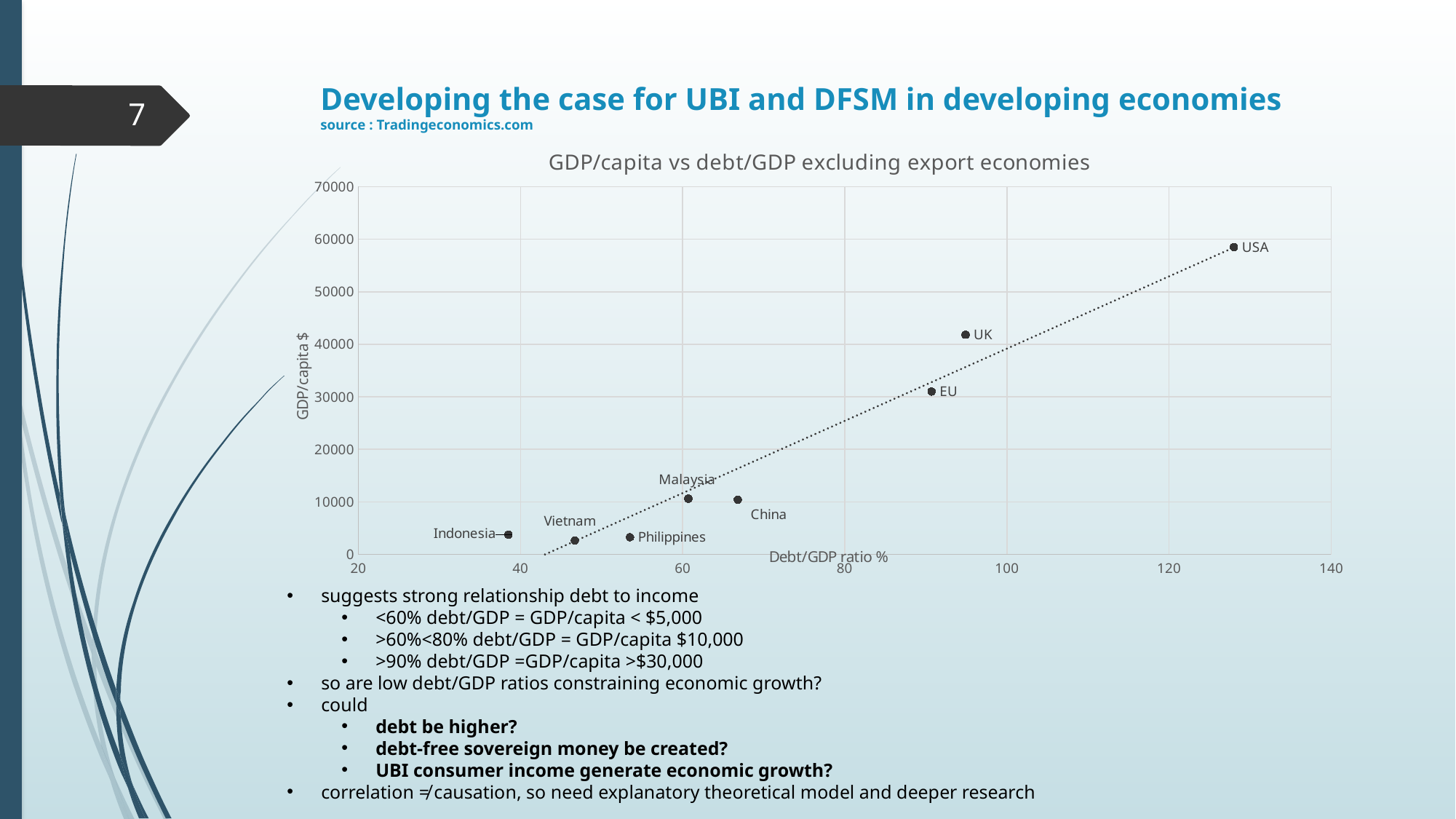
What is the title of the chart? GDP/capita vs debt/GDP excluding export economies Which labelled point has the highest GDP/capita? USA How many labelled data points are plotted on the chart? 8 What kind of chart is shown on the slide? scatter chart Which labelled point has the highest debt/GDP ratio? USA Is the debt/GDP ratio for the USA greater or less than 120? greater Which has a higher debt/GDP ratio, China or Malaysia? China Which has a higher GDP/capita, the UK or the EU? UK Is the GDP/capita value for the EU greater or less than 40000? less Which labelled point has the lowest debt/GDP ratio? Indonesia Is the GDP/capita value for the UK greater or less than 40000? greater Does GDP/capita generally rise or fall as the debt/GDP ratio increases along the x axis? rise